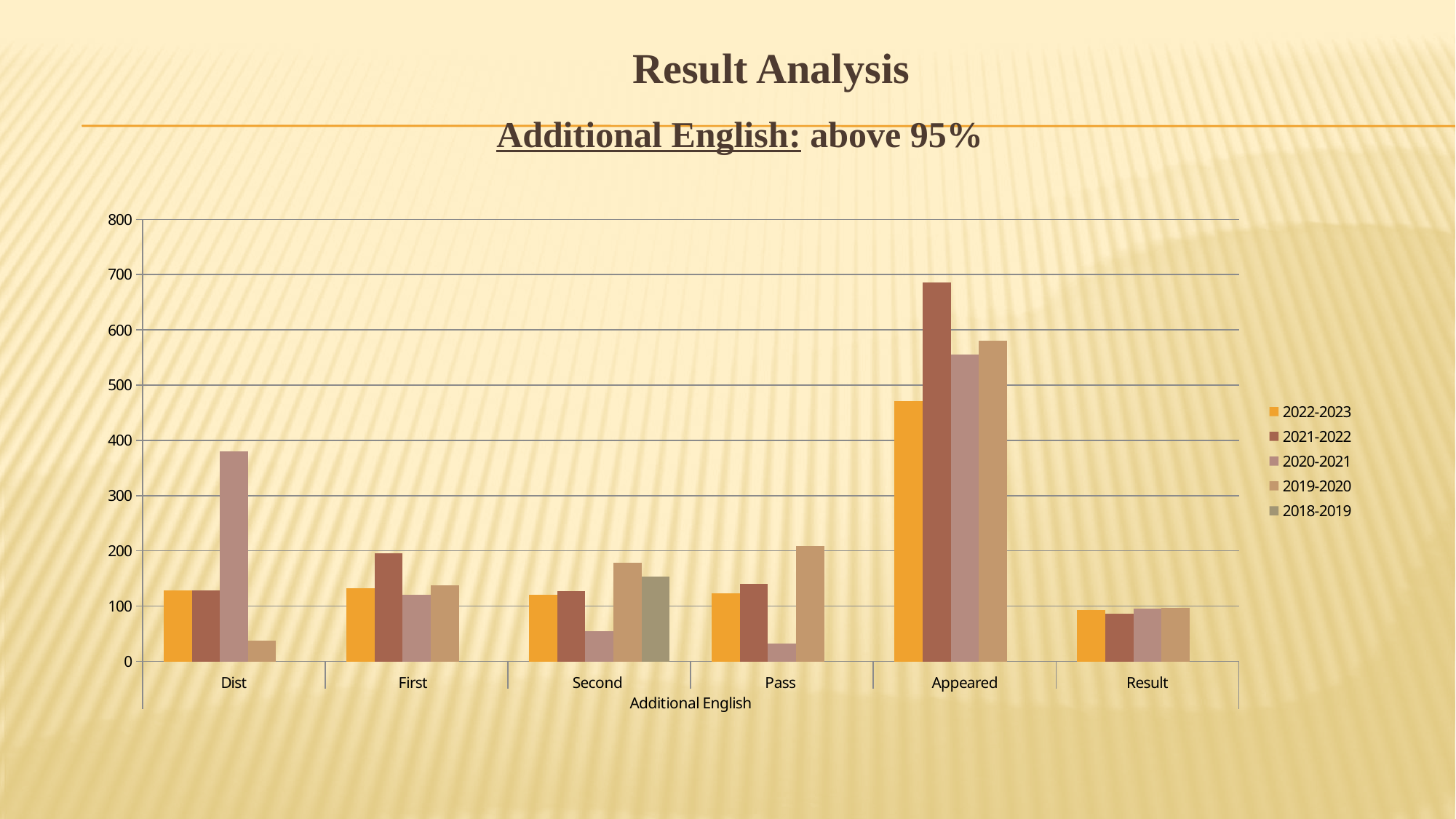
Is the 2021-2022 value for Appeared greater or less than 600? greater How many categories are shown on the x axis? 6 Within the Pass category, which series has the lowest bar? 2020-2021 What is the title shown on the x axis of the chart? Additional English Is the 2020-2021 value for Dist greater or less than 300? greater Which category has the highest bar for the 2021-2022 series? Appeared For the Appeared category, which is larger: the 2021-2022 value or the 2022-2023 value? 2021-2022 For the Dist category, which is larger: the 2020-2021 value or the 2019-2020 value? 2020-2021 Is the 2022-2023 value for Appeared greater or less than 400? greater How many series does the legend list? 5 What kind of chart is shown on the slide? bar chart